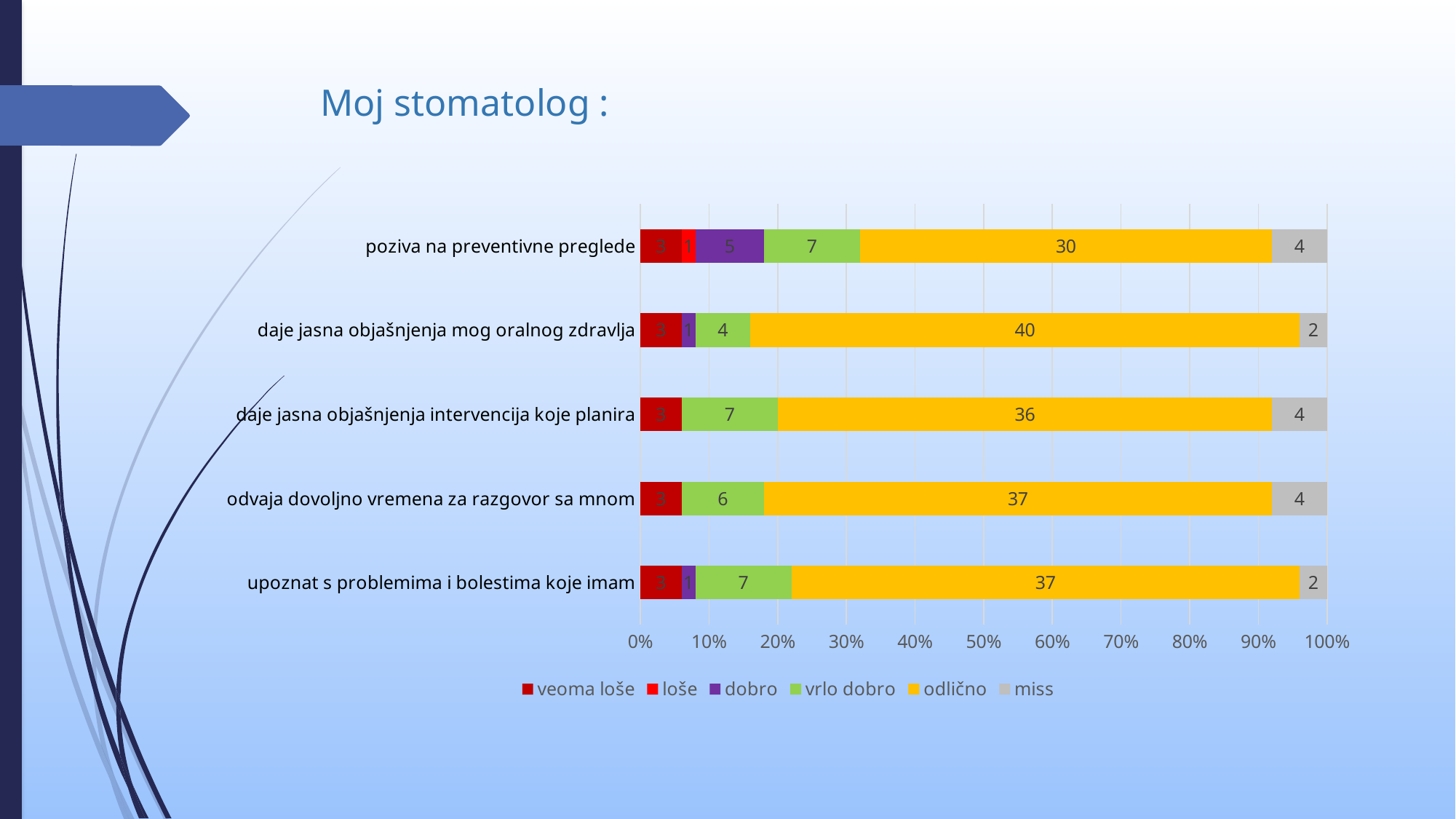
Which category has the lowest 'odlično' value? poziva na preventivne preglede How many series does the legend list? 6 Which category has the highest 'odlično' value? daje jasna objašnjenja mog oralnog zdravlja What is the value of the 'odlično' series for 'poziva na preventivne preglede'? 30 What kind of chart is shown on the slide? stacked bar chart What is the value of the 'vrlo dobro' series for 'odvaja dovoljno vremena za razgovor sa mnom'? 6 What is the value of the 'miss' series for 'upoznat s problemima i bolestima koje imam'? 2 What is the difference between the 'odlično' values for 'daje jasna objašnjenja mog oralnog zdravlja' and 'poziva na preventivne preglede'? 10 Which is larger: the 'vrlo dobro' value for 'poziva na preventivne preglede' or for 'daje jasna objašnjenja mog oralnog zdravlja'? poziva na preventivne preglede What is the total of all segments in the bar for 'poziva na preventivne preglede'? 50 What is the value of the 'odlično' series for 'daje jasna objašnjenja mog oralnog zdravlja'? 40 How many categories are shown on the chart? 5